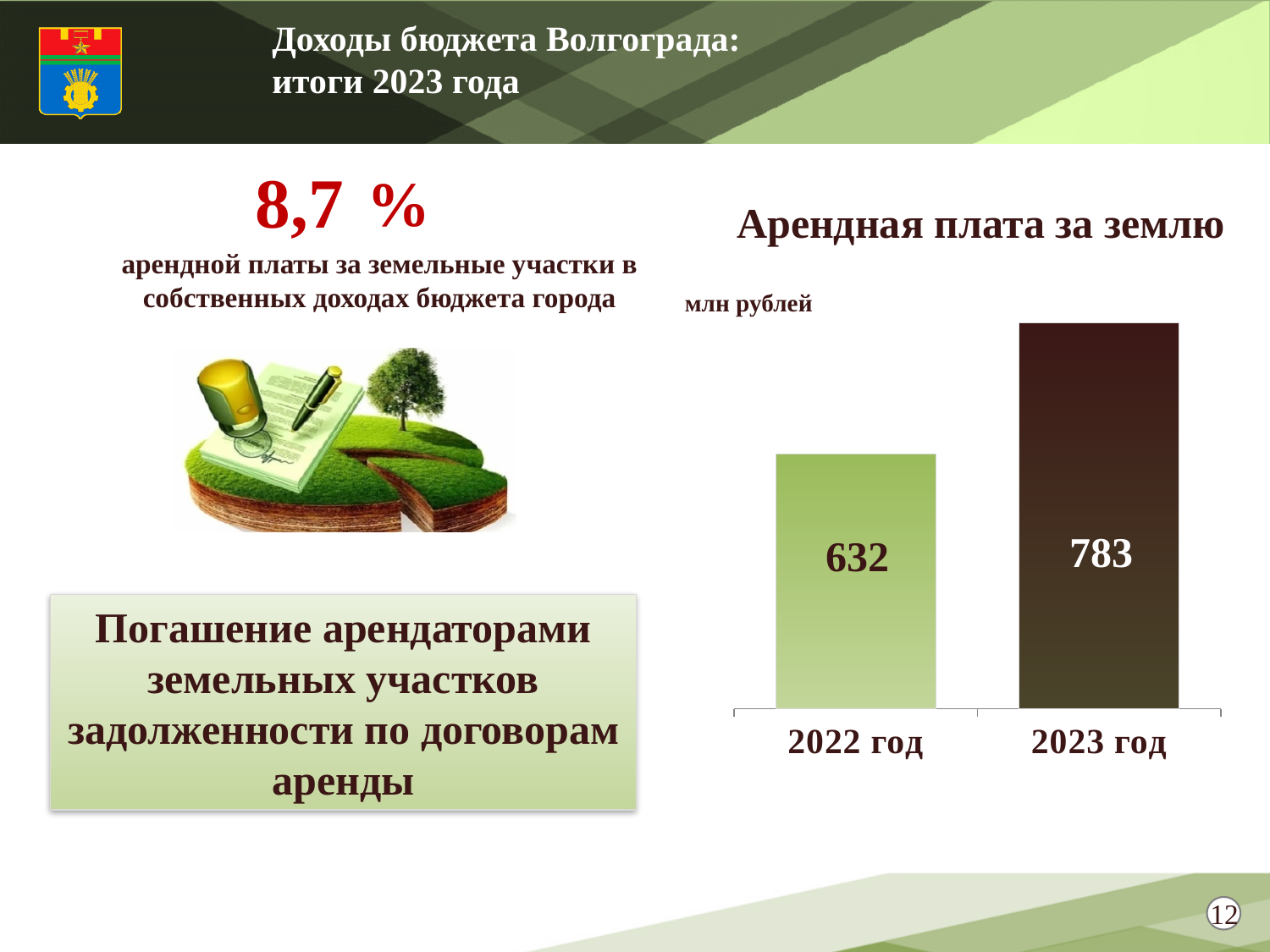
What is the title of the chart? Арендная плата за землю What kind of chart is shown on the slide? bar chart Is the value for 2023 год larger or smaller than the value for 2022 год? larger Do the values rise or fall from 2022 год to 2023 год? rise What is the value for 2022 год in the chart? 632 How many bars are shown in the chart? 2 What unit is indicated for the chart values? млн рублей What is the value for 2023 год in the chart? 783 Which year has the lower value in the chart? 2022 год What is the difference between the values for 2023 год and 2022 год? 151 Which year has the higher value in the chart? 2023 год